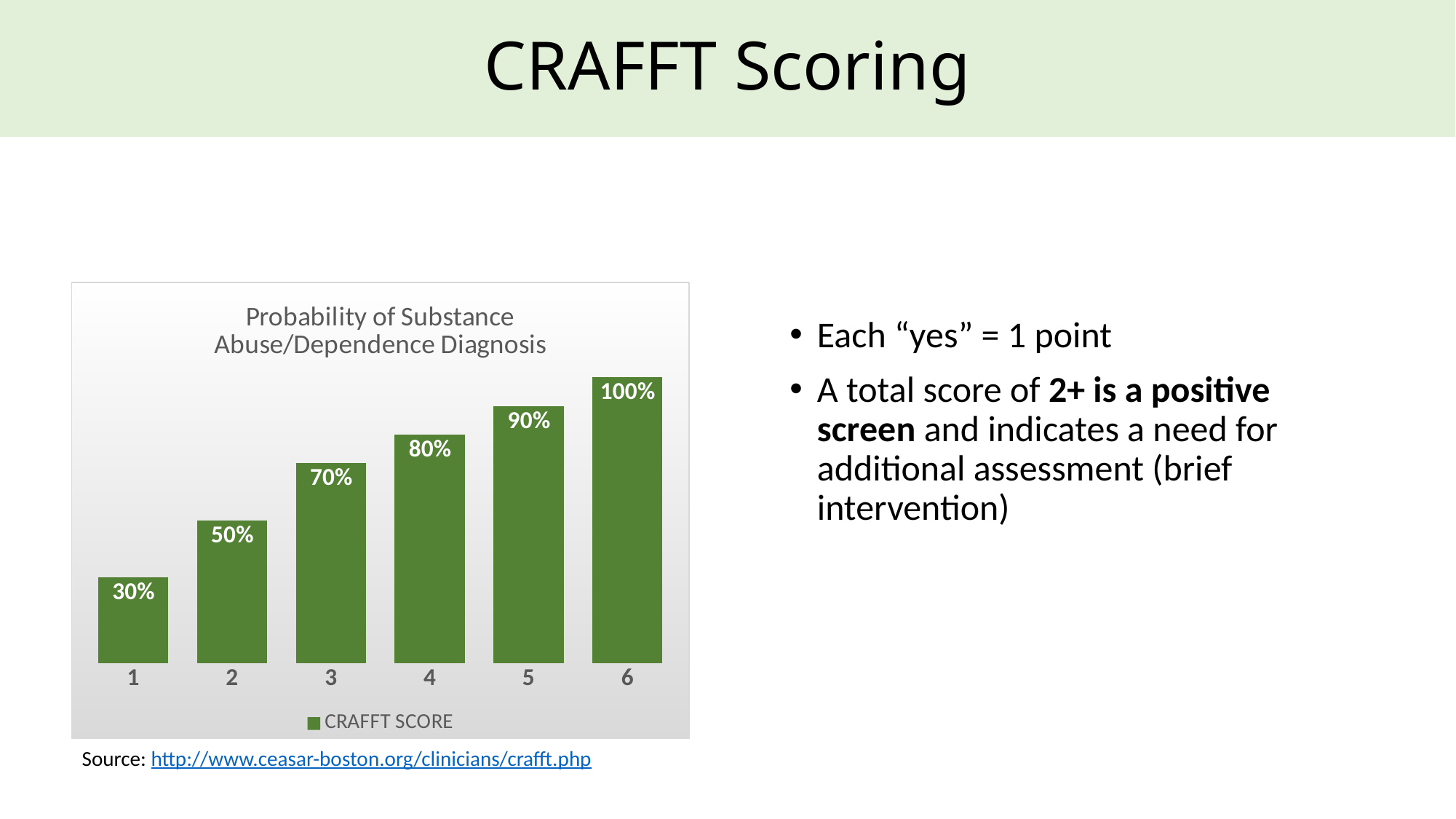
Do the probability values rise or fall as the CRAFFT score increases from 1 to 6? Rise How many series does the chart legend list? 1 Which CRAFFT score has the lowest probability of substance abuse/dependence diagnosis? 1 What is the probability of substance abuse/dependence diagnosis for a CRAFFT score of 4? 80% What is the probability of substance abuse/dependence diagnosis for a CRAFFT score of 6? 100% Which has a higher probability of diagnosis, a CRAFFT score of 2 or a CRAFFT score of 5? 5 What is the probability of substance abuse/dependence diagnosis for a CRAFFT score of 1? 30% What is the difference in probability between a CRAFFT score of 6 and a CRAFFT score of 1? 70% How many CRAFFT score categories are shown on the chart? 6 What is the difference in probability between a CRAFFT score of 3 and a CRAFFT score of 2? 20% What kind of chart is shown on the slide? Bar chart Which CRAFFT score has the highest probability of substance abuse/dependence diagnosis? 6